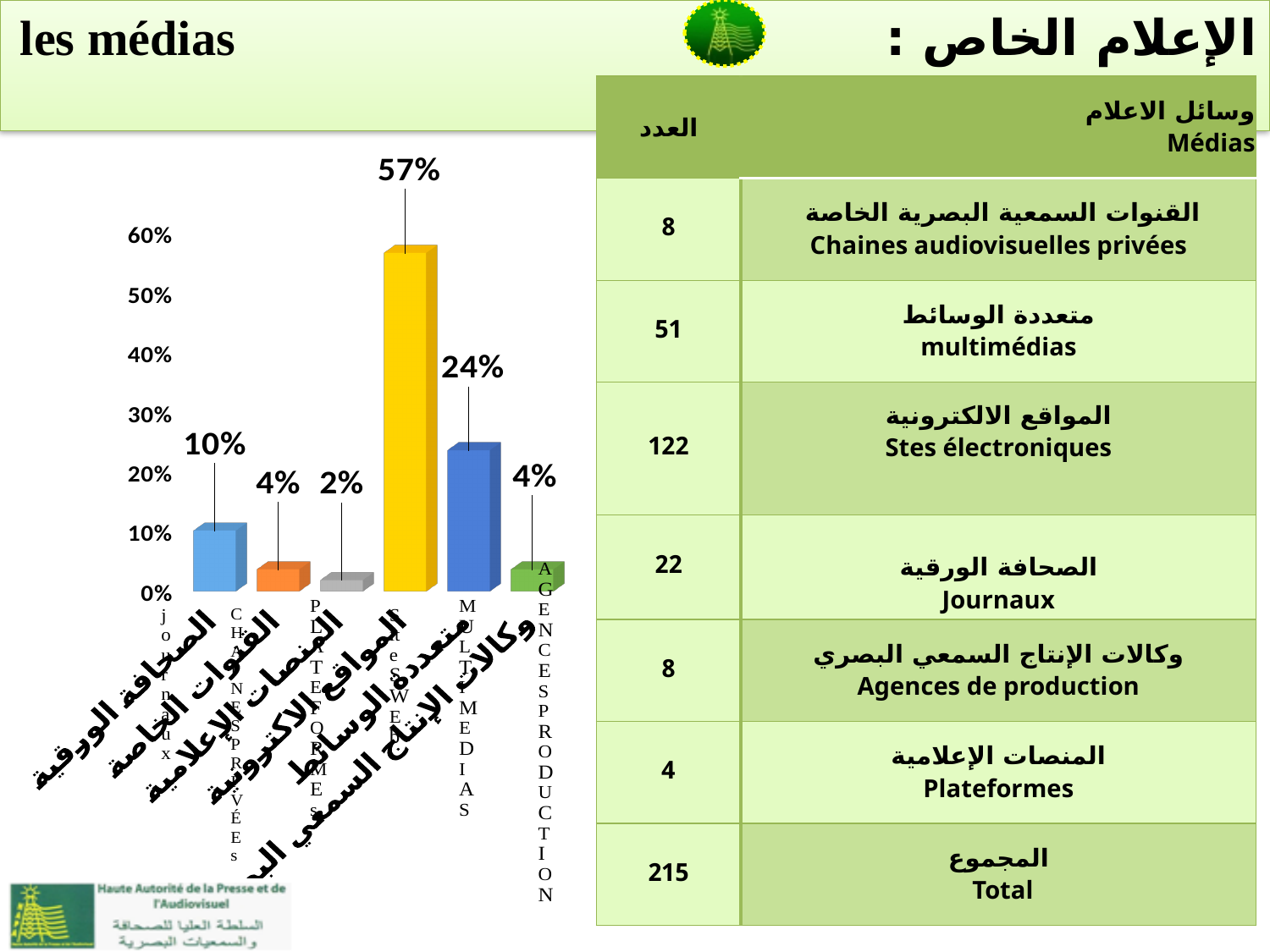
What is the maximum value shown on the chart's vertical axis? 60% What is the value of the fourth bar (the yellow one) in the chart? 57% What is the value of the first (leftmost) bar in the chart? 10% What is the value of the bar labelled AGENCES PRODUCTION? 4% What is the difference between the highest bar (57%) and the MULTIMEDIAS bar (24%)? 33% What type of chart is shown on the left of the slide? bar chart How many bars are plotted in the chart? 6 Is the value of the yellow bar greater or less than 50%? greater What is the highest value shown in the chart? 57% Which is larger, the first bar (journaux) or the MULTIMEDIAS bar? MULTIMEDIAS What is the lowest value shown in the chart? 2% What is the value of the bar labelled MULTIMEDIAS? 24%